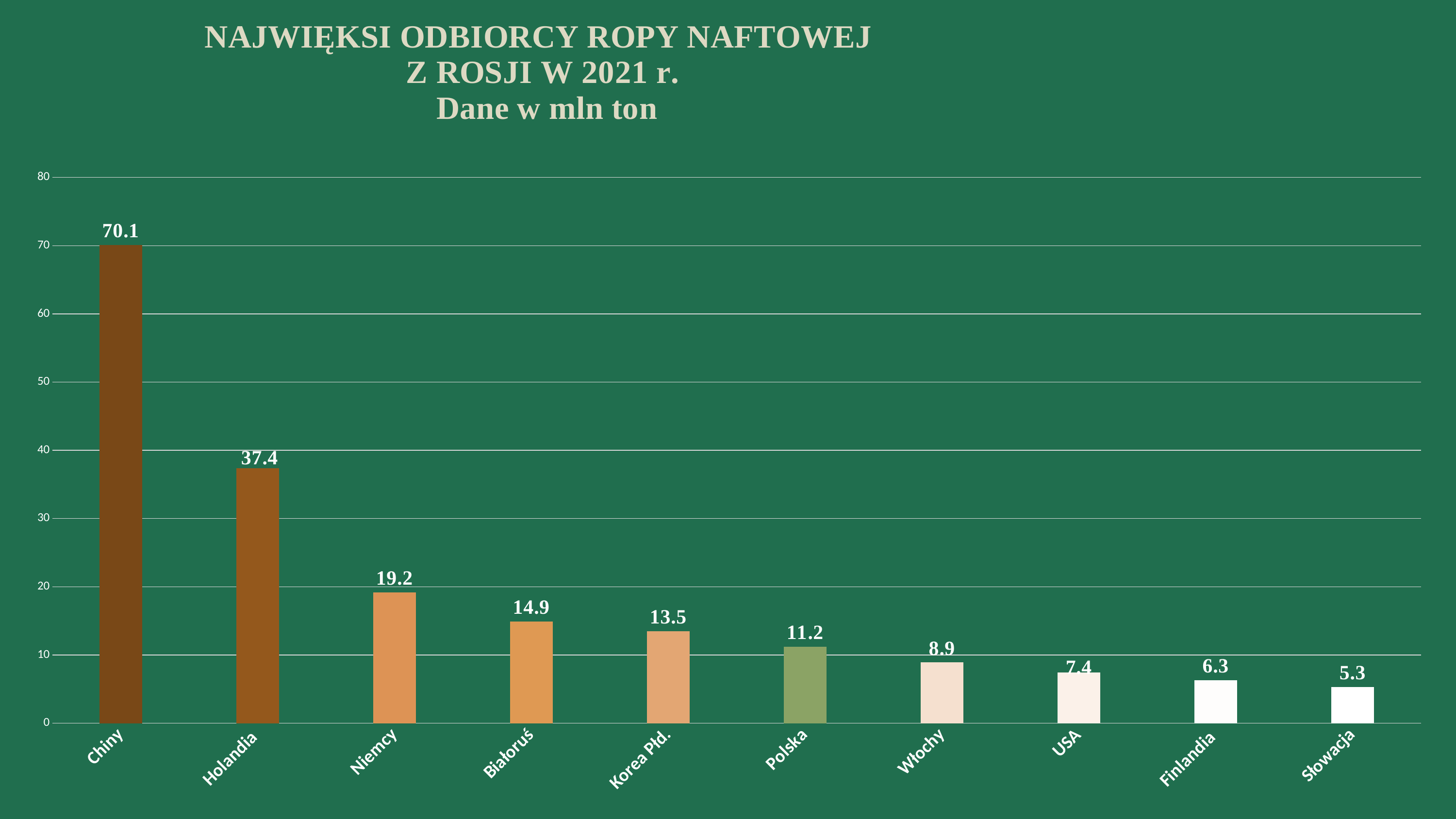
Which country has the lowest value? Słowacja What is the difference between the values for Chiny and Holandia? 32.7 What is the value for Chiny? 70.1 Which is larger, the value for Włochy or the value for USA? Włochy How many countries are shown on the chart? 10 What is the value for Polska? 11.2 What is the value for Korea Płd.? 13.5 What is the difference between the values for Niemcy and Białoruś? 4.3 Is the value for Holandia greater or less than 40? less Do the values rise or fall from left to right along the x axis? fall What kind of chart is shown on the slide? bar chart Which country has the highest value? Chiny